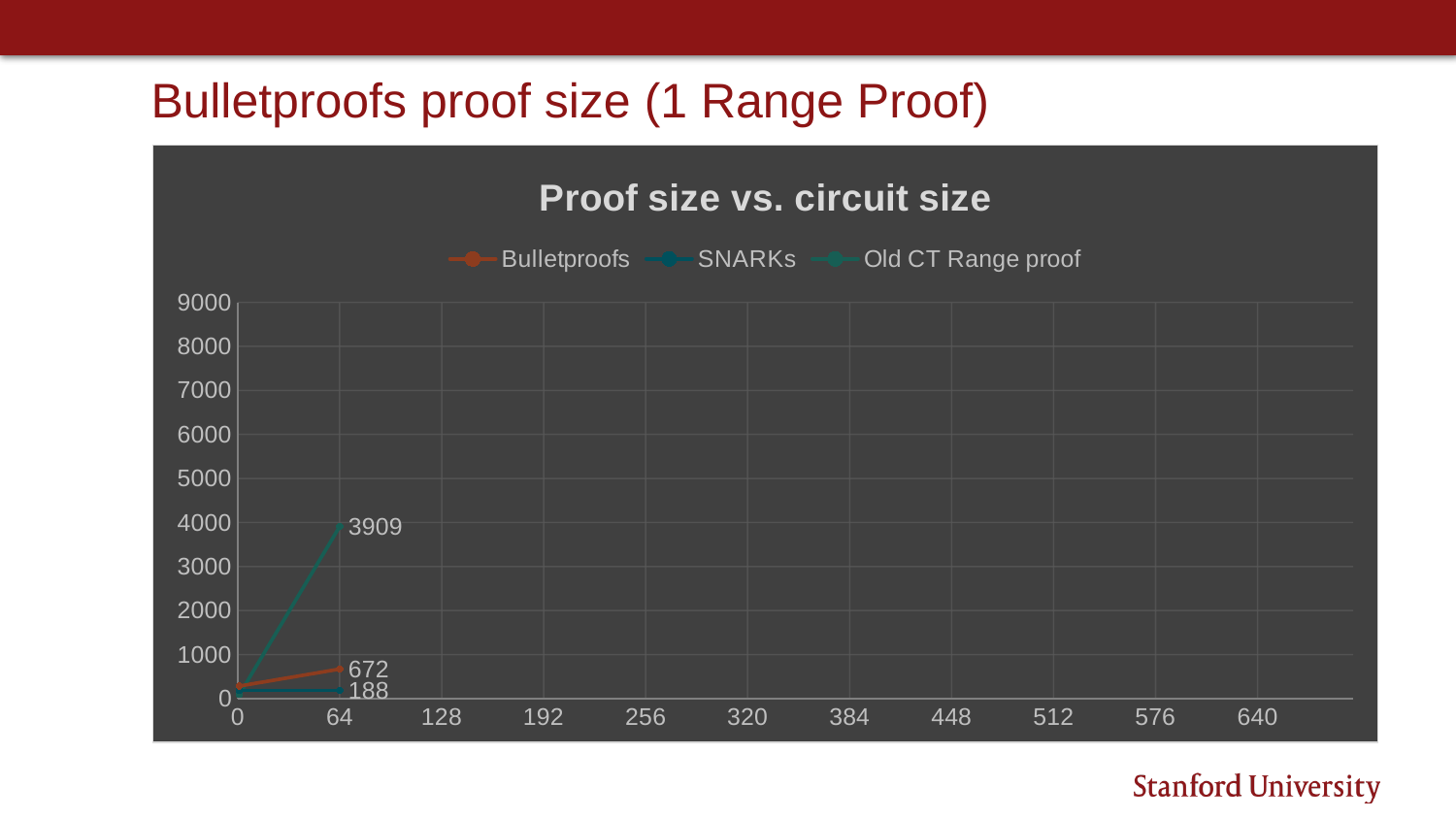
What is the difference between the Bulletproofs value and the SNARKs value at circuit size 64? 484 Does the Old CT Range proof series rise or fall from circuit size 0 to 64? rise What kind of chart is shown on the slide? line chart What is the value of the Bulletproofs series at circuit size 64? 672 What is the value of the Old CT Range proof series at circuit size 64? 3909 At circuit size 64, which is larger: the Bulletproofs value or the SNARKs value? Bulletproofs Which series has the lowest value at circuit size 64? SNARKs What is the chart's title? Proof size vs. circuit size How many series does the legend list? 3 What is the value of the SNARKs series at circuit size 64? 188 Which series has the highest value at circuit size 64? Old CT Range proof What is the difference between the Old CT Range proof value and the Bulletproofs value at circuit size 64? 3237